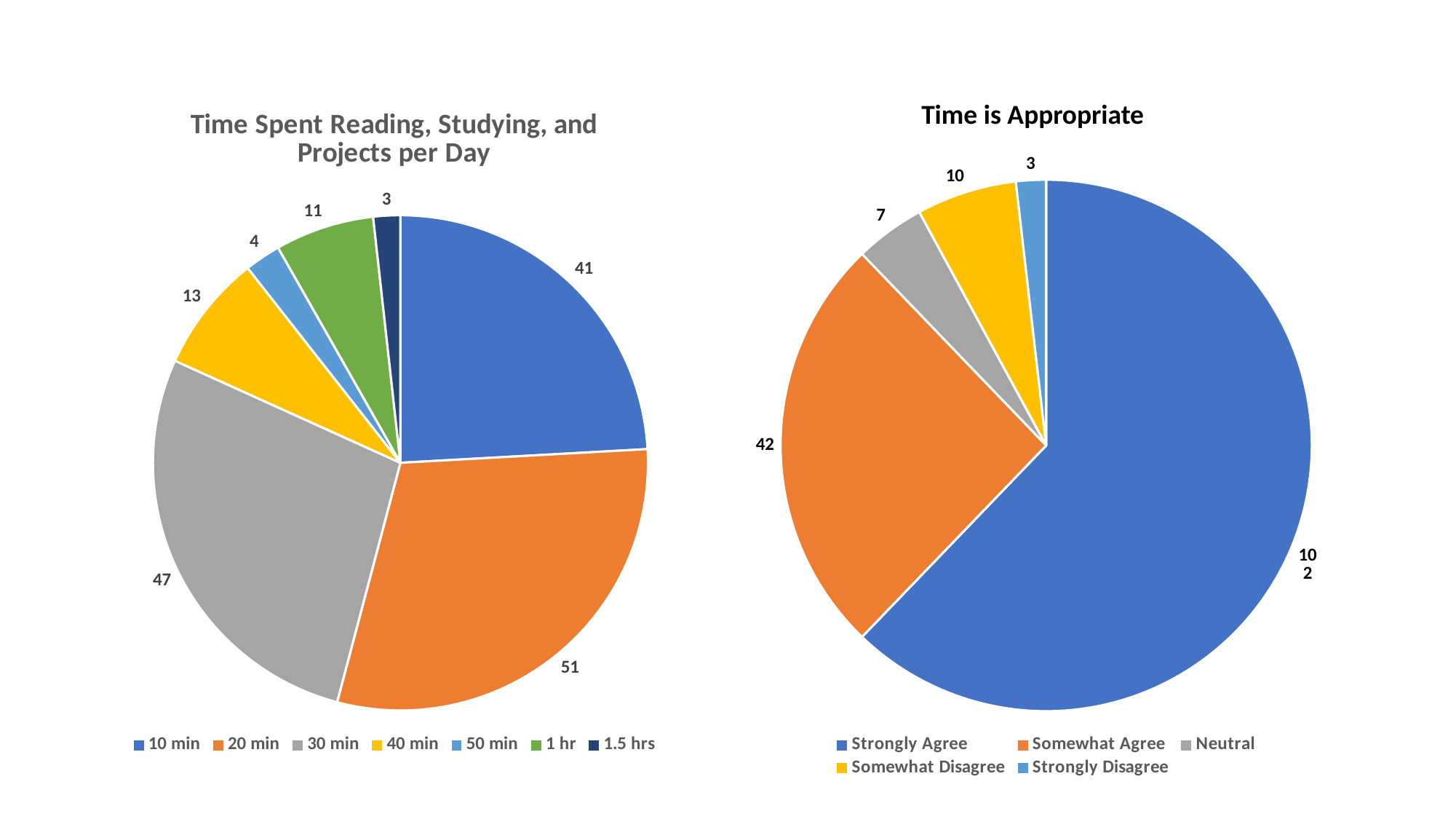
On the 'Time Spent Reading, Studying, and Projects per Day' chart, which category has the smallest slice? 1.5 hrs On the 'Time is Appropriate' chart, what is the value for Somewhat Agree? 42 On the 'Time Spent Reading, Studying, and Projects per Day' chart, what is the value for 20 min? 51 On the 'Time Spent Reading, Studying, and Projects per Day' chart, how many categories does the legend list? 7 On the 'Time is Appropriate' chart, what is the difference between the values for Somewhat Disagree and Strongly Disagree? 7 On the 'Time Spent Reading, Studying, and Projects per Day' chart, which category has the largest slice? 20 min On the 'Time Spent Reading, Studying, and Projects per Day' chart, what is the difference between the values for 30 min and 40 min? 34 On the 'Time Spent Reading, Studying, and Projects per Day' chart, what share of the total does the 20 min slice represent? 30% What kind of chart is the 'Time is Appropriate' chart? Pie chart On the 'Time Spent Reading, Studying, and Projects per Day' chart, what is the value for 1 hr? 11 On the 'Time is Appropriate' chart, which category has the largest slice? Strongly Agree On the 'Time is Appropriate' chart, which is larger, Neutral or Somewhat Disagree? Somewhat Disagree